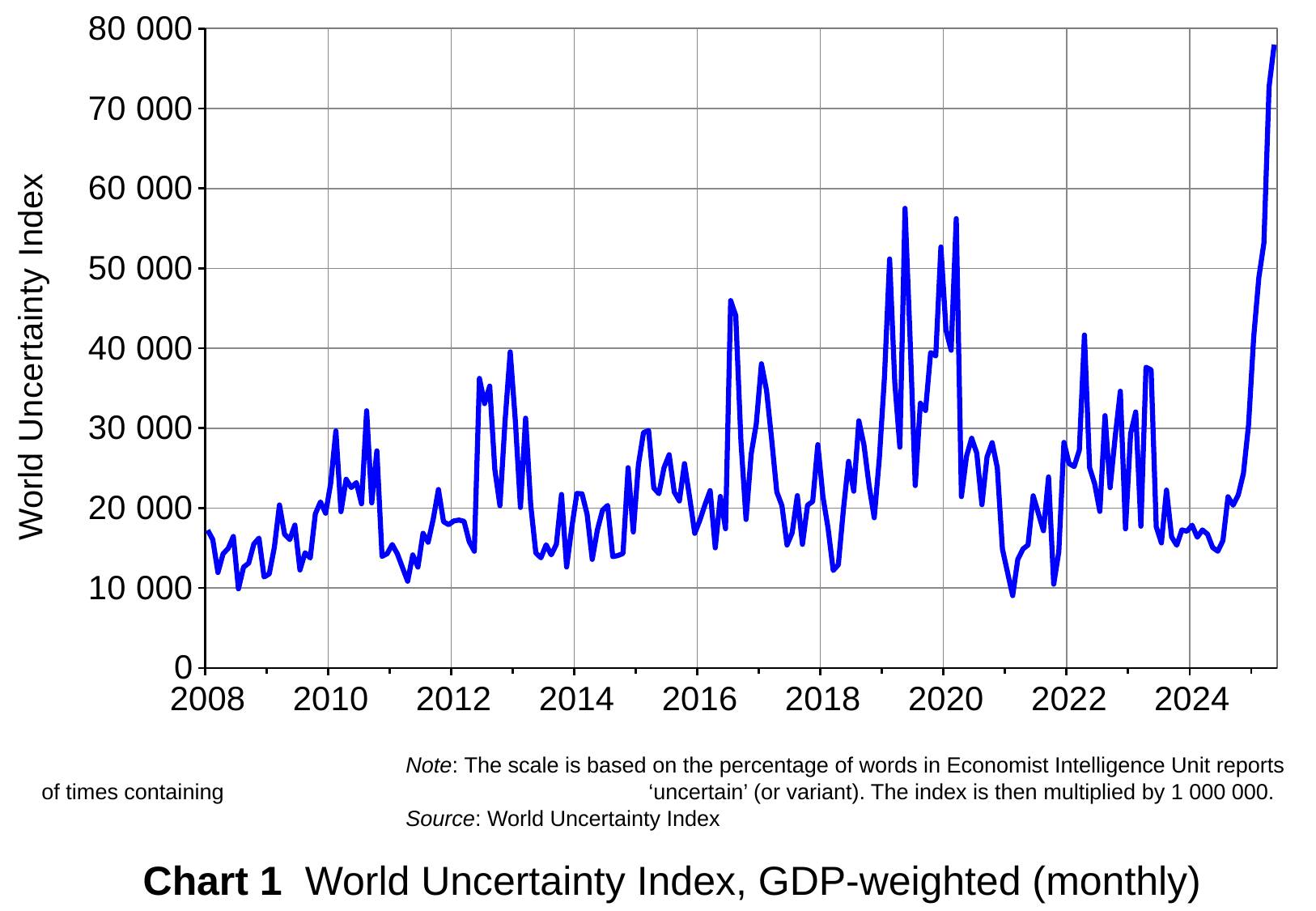
Which is larger: the peak of the World Uncertainty Index in 2019 or the peak in 2013? the peak in 2019 What is the title of the chart? Chart 1 World Uncertainty Index, GDP-weighted (monthly) Does the World Uncertainty Index reach its highest value at the beginning or at the end of the period shown? at the end Is the value of the World Uncertainty Index at the very end of the series (after 2024) greater or less than 70 000? greater Is the highest peak of the World Uncertainty Index in 2019 greater or less than 50 000? greater Is the lowest value of the World Uncertainty Index in 2021 greater or less than 20 000? less What is the highest value shown on the vertical axis of the chart? 80 000 What kind of chart is shown on the slide? line chart Does the World Uncertainty Index rise or fall from 2024 to the end of the series? rise What is the label on the vertical axis of the chart? World Uncertainty Index How many data series are plotted on the chart? 1